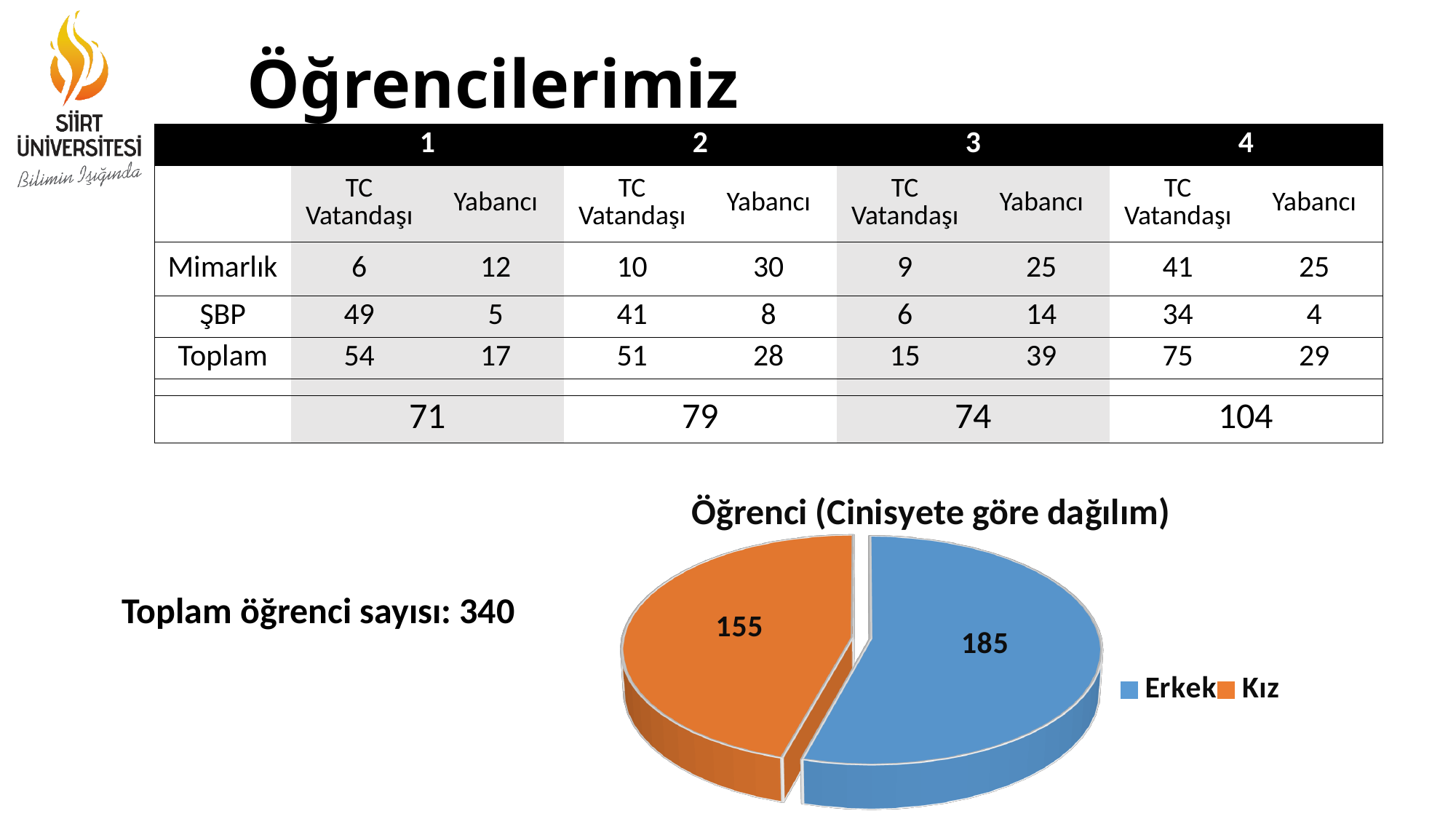
In the pie chart, what is the value for Erkek? 185 Which slice of the pie chart is the smallest? Kız Which colour represents Kız in the pie chart? orange How many slices does the pie chart have? 2 What kind of chart is shown on the slide? pie chart What is the difference between the Erkek and Kız values in the pie chart? 30 Which slice of the pie chart is the largest? Erkek In the pie chart, what is the value for Kız? 155 What is the title of the pie chart? Öğrenci (Cinisyete göre dağılım) In the pie chart, is the value for Erkek or Kız larger? Erkek What is the total of the two slices in the pie chart? 340 How many entries does the pie chart's legend list? 2